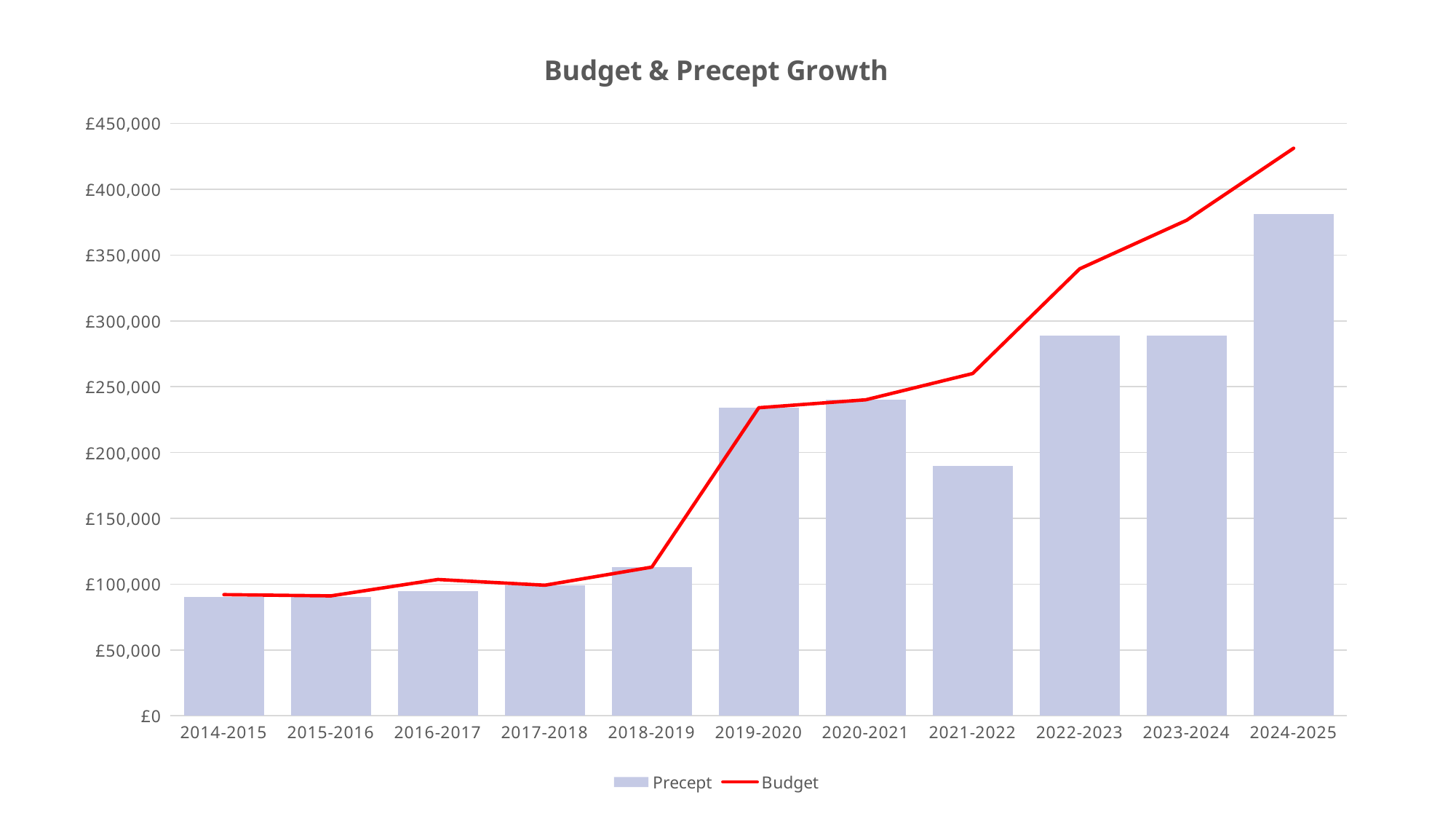
What is the title of the chart? Budget & Precept Growth Does the Budget line generally rise or fall from 2014-2015 to 2024-2025? Rise Which year has the highest Precept bar? 2024-2025 Is the Precept value for 2021-2022 greater or less than £200,000? less Which series is drawn as a red line? Budget What kind of chart is this? A combined bar and line chart How many financial years are shown on the x axis? 11 How many series does the legend list? 2 Is the Budget value for 2022-2023 greater or less than £300,000? greater In 2022-2023, which is larger, the Budget or the Precept? Budget Which year has the highest Budget value? 2024-2025 Is the Precept value for 2024-2025 greater or less than £350,000? greater